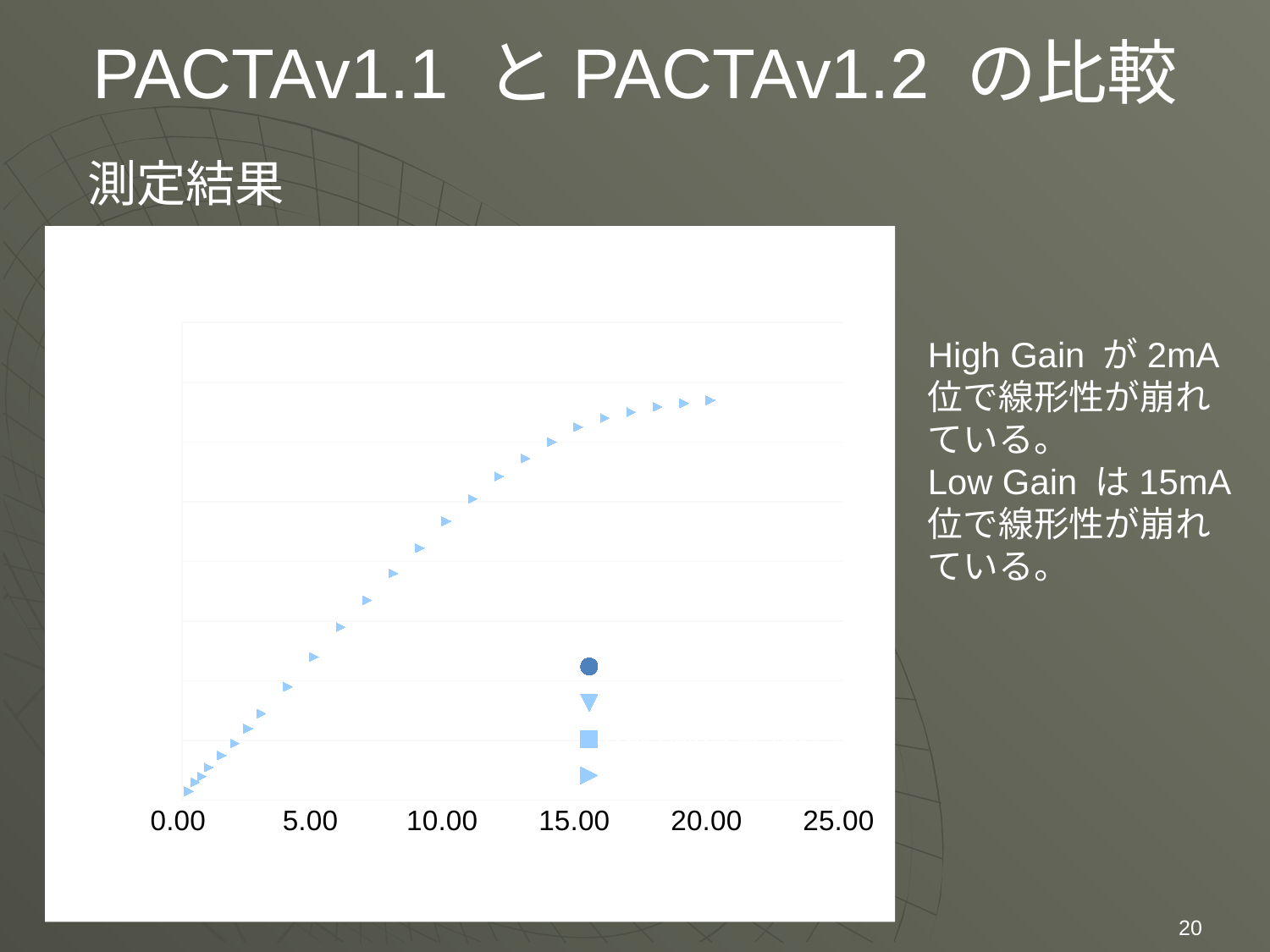
What is the largest tick label shown on the x axis? 25.00 How many marker symbols does the legend show? 4 Is the x value of the rightmost plotted point greater or less than 15.00? greater Is the x value of the rightmost plotted point greater or less than 25.00? less What is the smallest tick label shown on the x axis? 0.00 What kind of chart is shown on the slide? scatter chart Do the plotted values rise or fall as the x value increases? rise